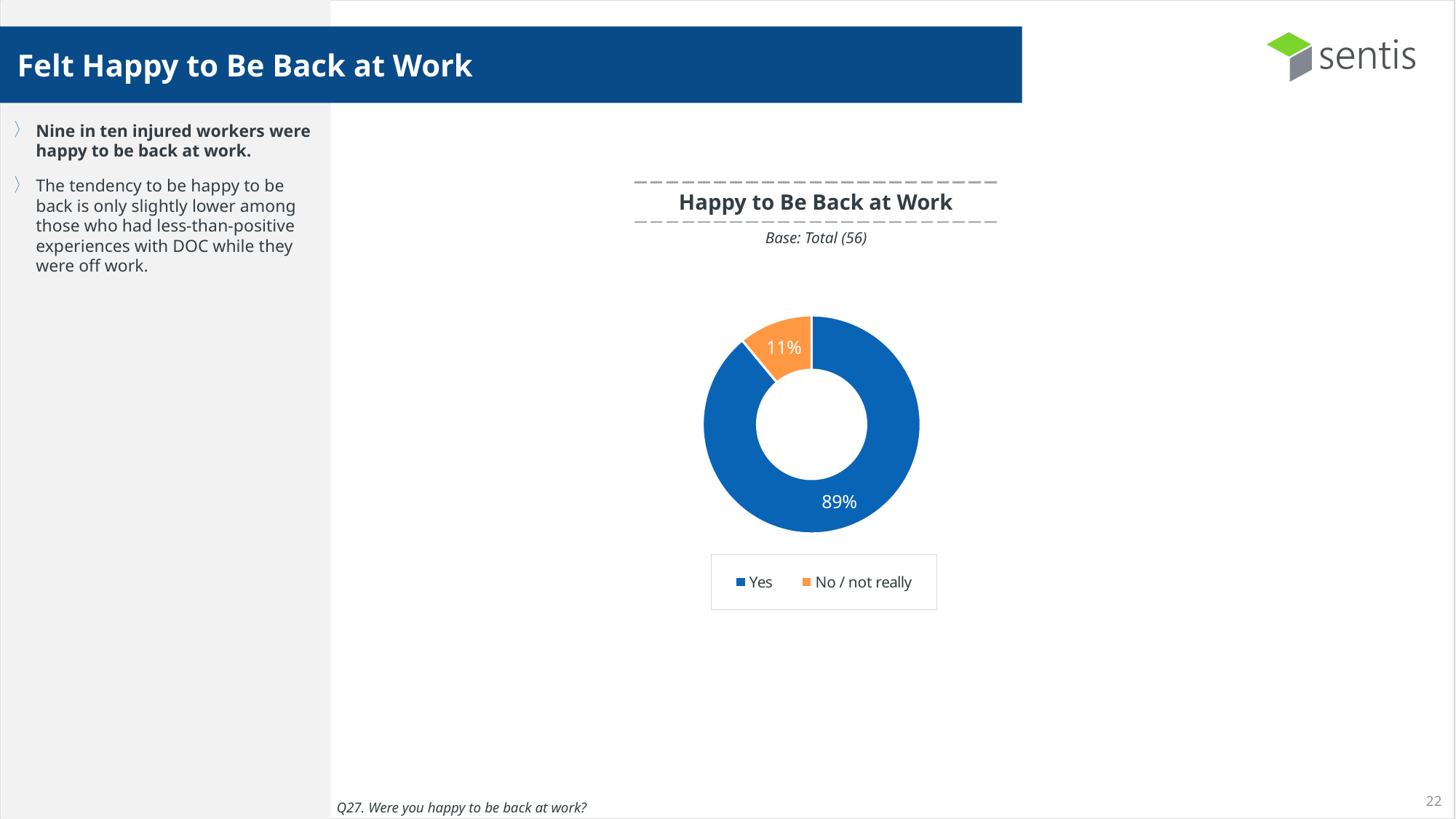
How many categories are shown in the Happy to Be Back at Work chart? 2 How many entries does the legend of the Happy to Be Back at Work chart list? 2 Which category has the smallest share in the Happy to Be Back at Work chart? No / not really Which category has the largest share in the Happy to Be Back at Work chart? Yes What percentage of respondents answered Yes in the Happy to Be Back at Work chart? 89% What kind of chart is the Happy to Be Back at Work chart? Pie chart (doughnut) What colour represents the Yes category in the Happy to Be Back at Work chart? Blue What is the title of the chart on the slide? Happy to Be Back at Work What is the base size shown under the Happy to Be Back at Work chart title? Total (56) Which is larger in the Happy to Be Back at Work chart, the Yes share or the No / not really share? Yes What is the difference in percentage points between the Yes and No / not really shares in the Happy to Be Back at Work chart? 78 percentage points What percentage of respondents answered No / not really in the Happy to Be Back at Work chart? 11%